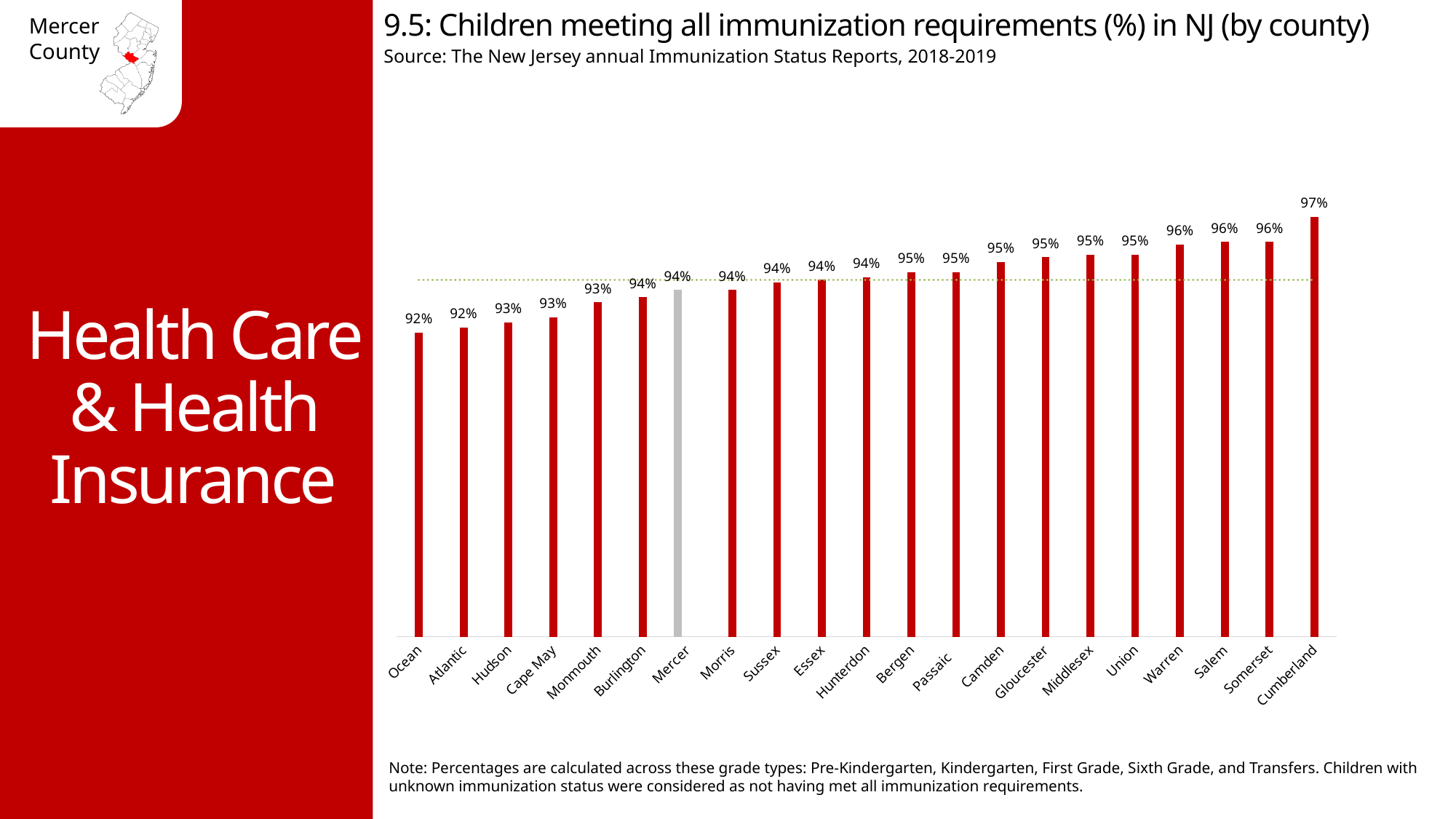
How many counties are shown on the chart? 21 Which county has the highest percentage of children meeting all immunization requirements? Cumberland What is the difference between the values for Cumberland and Ocean? 5 percentage points What is the value for Bergen county? 95% What is the value for Ocean county? 92% Which county's bar is coloured grey instead of red? Mercer What is the value for Mercer county? 94% What type of chart is shown on the slide? Bar chart Which has a higher value, Hudson or Somerset? Somerset What is the value for Cumberland county? 97% What is the value for Warren county? 96% Do the values rise or fall moving from left to right along the x axis? Rise